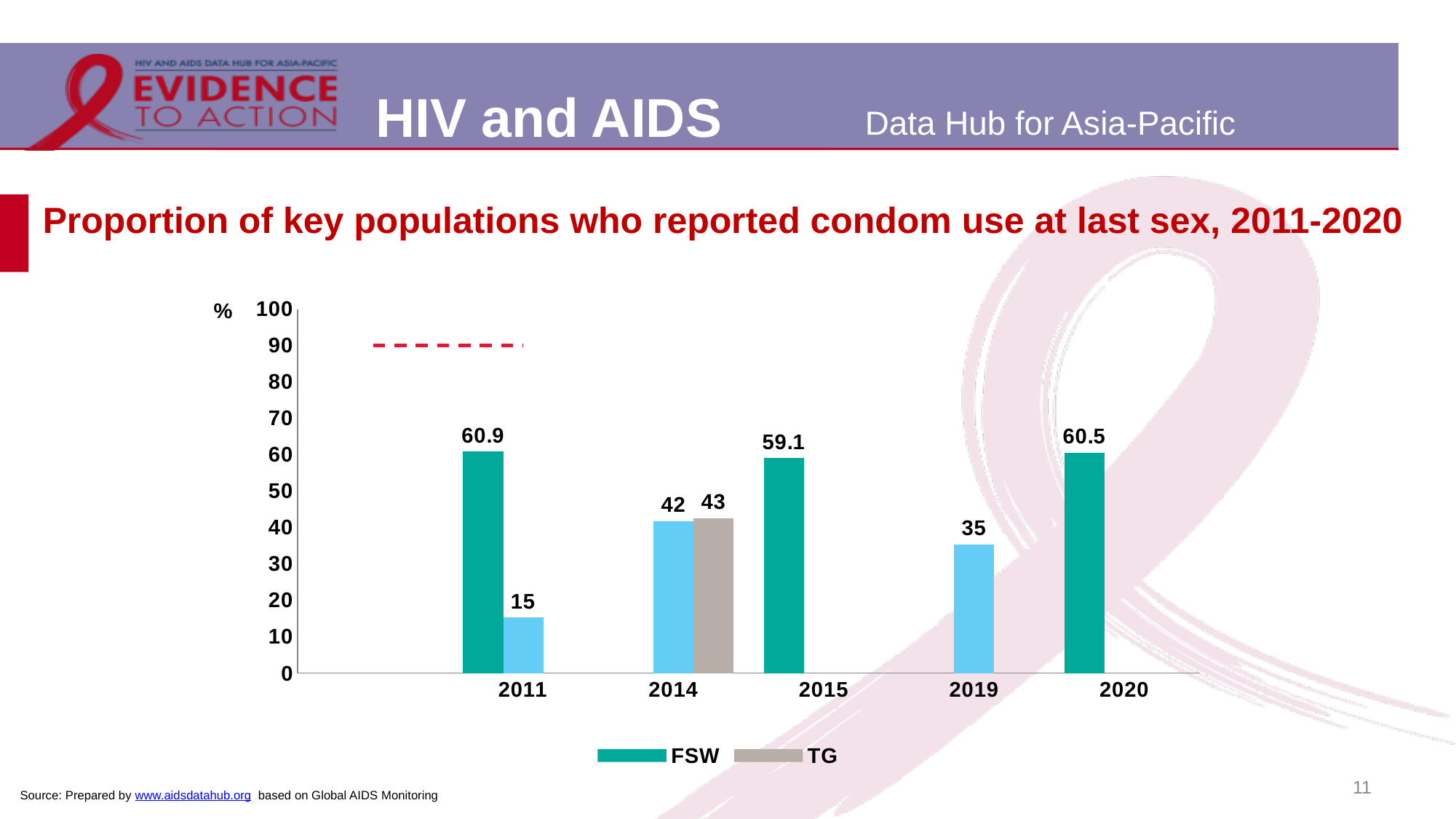
What is the value for FSW in 2020? 60.5 What is the value for FSW in 2011? 60.9 What is the value for TG in 2014? 43 How many series does the legend list? 2 How many years are shown on the x axis? 5 What is the value for FSW in 2015? 59.1 In which year is the FSW value highest? 2011 Is the value for FSW in 2020 greater or less than 50? greater Which is larger, the FSW value in 2011 or in 2015? 2011 In which year is the FSW value lowest? 2015 What is the difference between the FSW values in 2011 and 2020? 0.4 What kind of chart is shown on the slide? bar chart